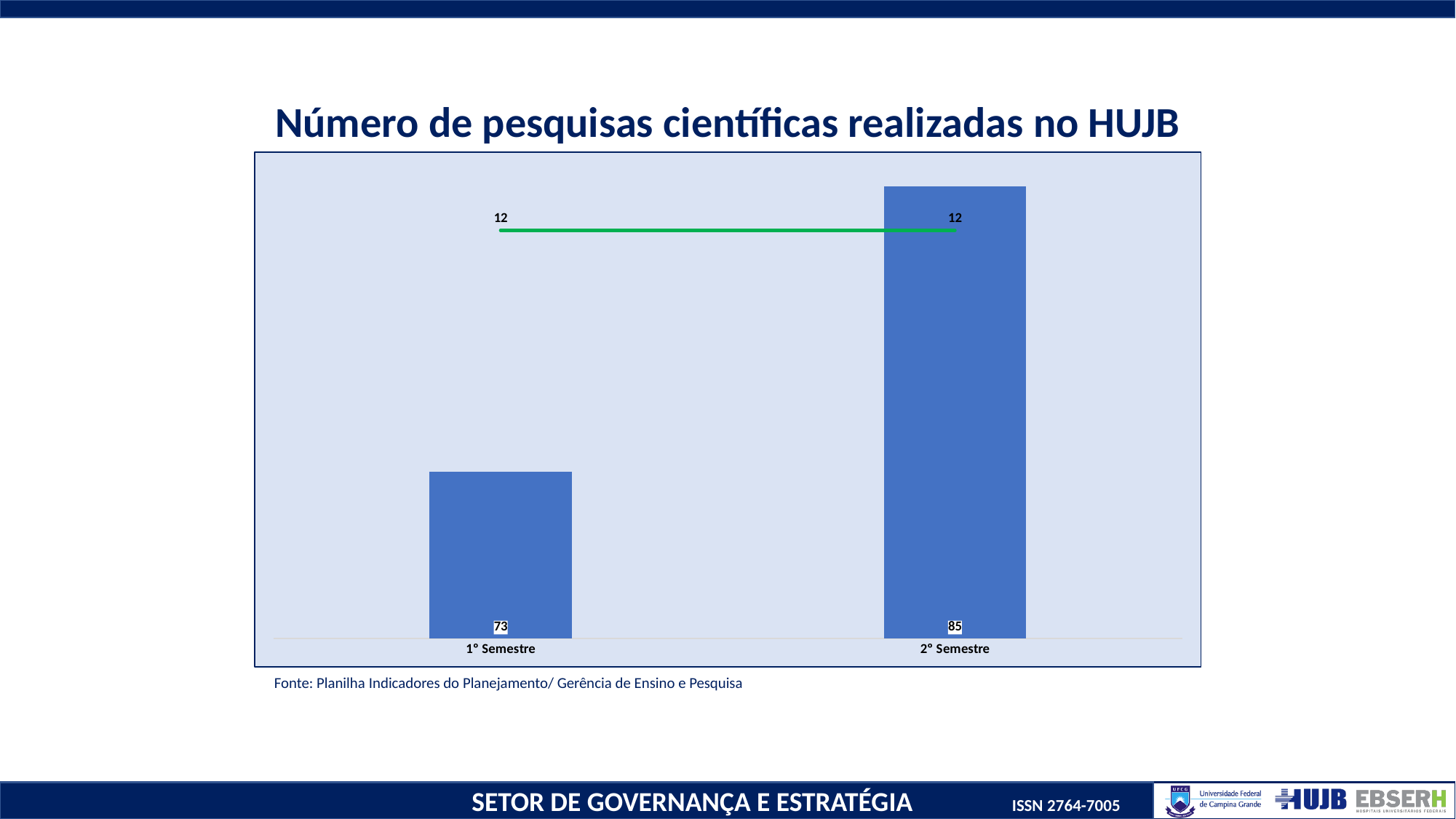
What is the value for 2° Semestre? 85 How many categories are shown on the x axis? 2 What value is labelled on the green horizontal line? 12 What is the title of the chart? Número de pesquisas científicas realizadas no HUJB Which category has the lowest bar? 1° Semestre What is the value for 1° Semestre? 73 Which category has the highest bar? 2° Semestre What kind of chart is shown on the slide? Combination bar and line chart Which is larger, the value for 1° Semestre or the value for 2° Semestre? 2° Semestre Do the bar values rise or fall from 1° Semestre to 2° Semestre? Rise What is the difference between the values for 2° Semestre and 1° Semestre? 12